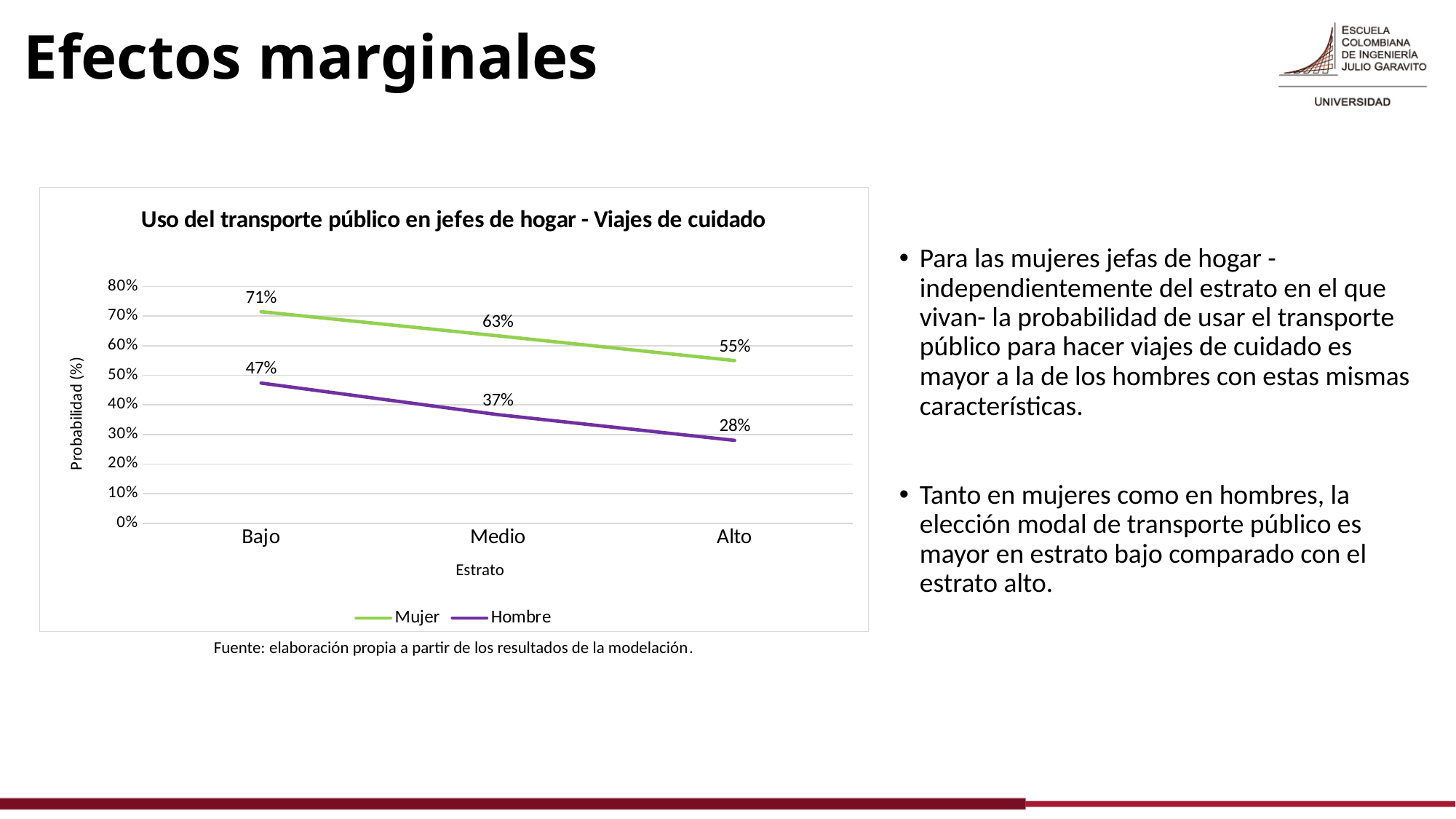
What is the difference between the Mujer and Hombre values at the Medio estrato? 26% What kind of chart is shown on the slide? Line chart What is the value for Hombre at the Alto estrato? 28% What is the value for Hombre at the Medio estrato? 37% At which estrato is the Hombre series lowest? Alto How many series does the legend list? 2 What is the value for Mujer at the Alto estrato? 55% How many estrato categories are shown on the x axis? 3 Do the Hombre values rise or fall from Bajo to Alto? Fall What is the value for Mujer at the Bajo estrato? 71% At which estrato is the Mujer series highest? Bajo Which is larger at the Bajo estrato, the Mujer value or the Hombre value? Mujer